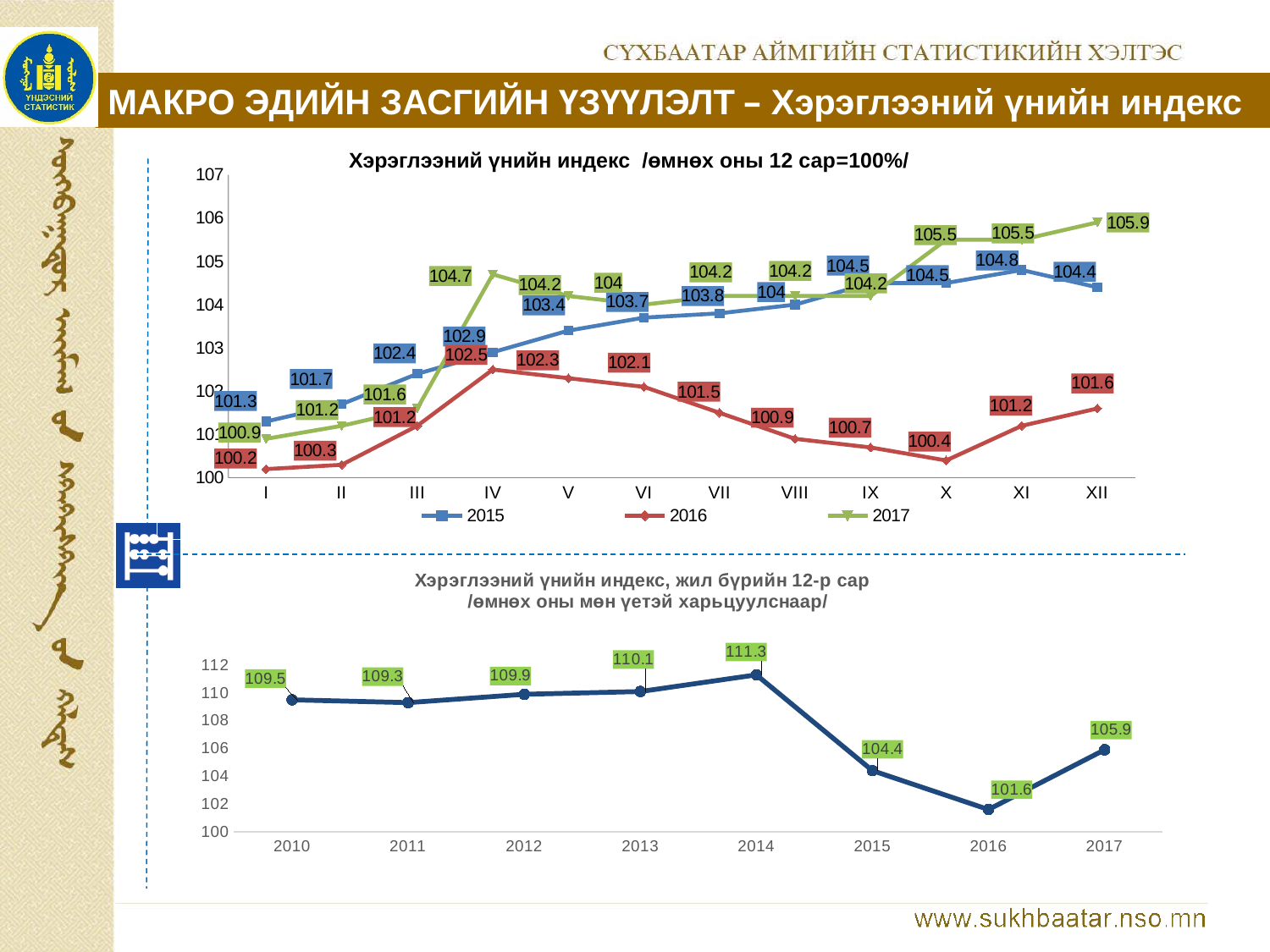
In the bottom chart (Хэрэглээний үнийн индекс, жил бүрийн 12-р сар), how many years are plotted? 8 In the top chart (Хэрэглээний үнийн индекс /өмнөх оны 12 сар=100%/), which series has the higher value in month XII, 2015 or 2017? 2017 In the bottom chart (Хэрэглээний үнийн индекс, жил бүрийн 12-р сар), do the values rise or fall from 2014 to 2016? fall In the bottom chart (Хэрэглээний үнийн индекс, жил бүрийн 12-р сар), which year has the lowest value? 2016 In the bottom chart (Хэрэглээний үнийн индекс, жил бүрийн 12-р сар), what is the difference between the values for 2017 and 2016? 4.3 In the top chart (Хэрэглээний үнийн индекс /өмнөх оны 12 сар=100%/), how many series does the legend list? 3 In the top chart (Хэрэглээний үнийн индекс /өмнөх оны 12 сар=100%/), what is the 2015 value for month I? 101.3 In the top chart (Хэрэглээний үнийн индекс /өмнөх оны 12 сар=100%/), what is the 2016 value for month IV? 102.5 In the top chart (Хэрэглээний үнийн индекс /өмнөх оны 12 сар=100%/), what is the 2017 value for month XII? 105.9 What kind of chart is the top chart (Хэрэглээний үнийн индекс /өмнөх оны 12 сар=100%/)? line chart In the bottom chart (Хэрэглээний үнийн индекс, жил бүрийн 12-р сар), what is the value for 2014? 111.3 In the bottom chart (Хэрэглээний үнийн индекс, жил бүрийн 12-р сар), which year has the highest value? 2014